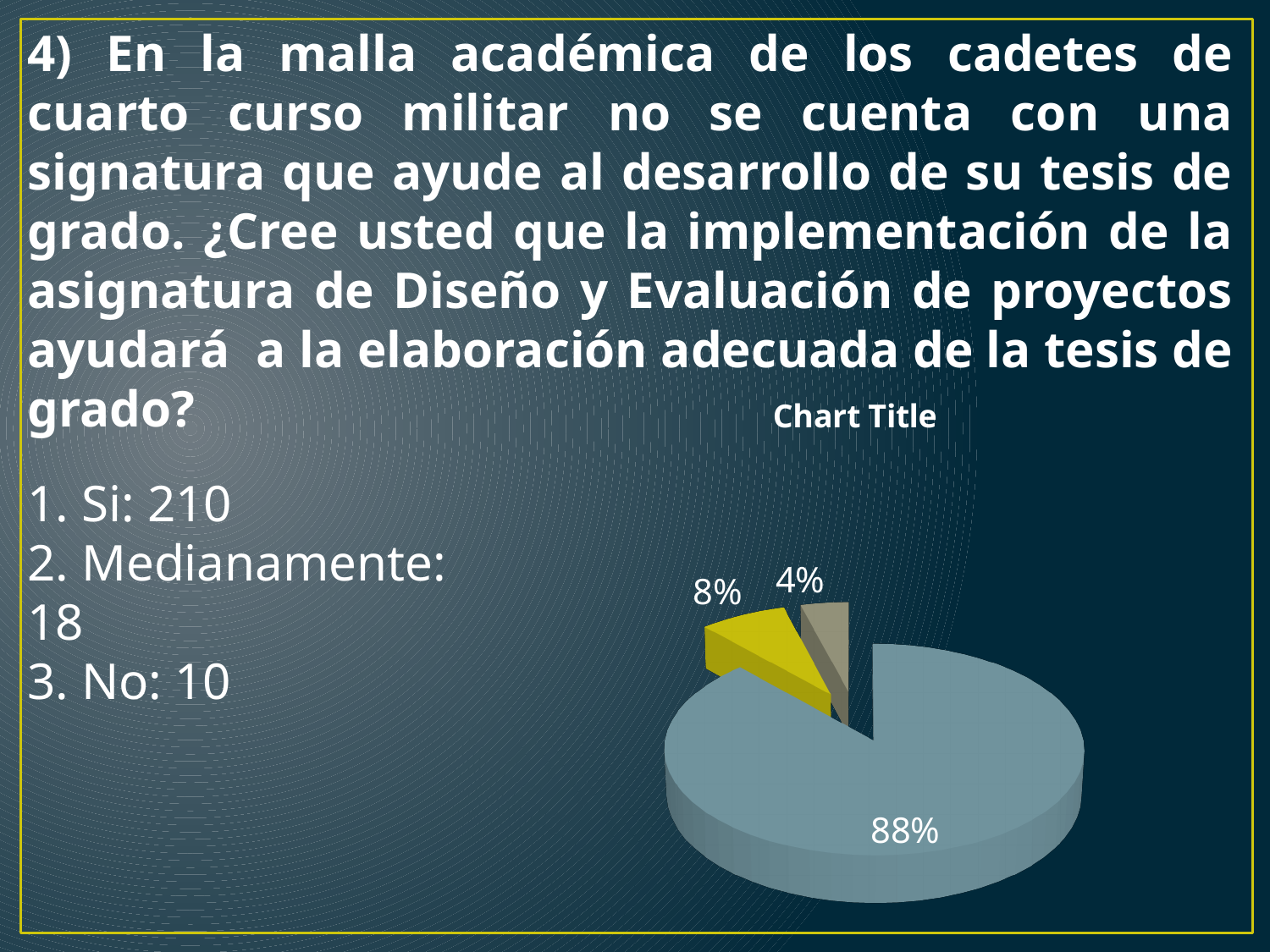
What is the percentage shown on the largest slice of the pie chart? 88% What percentage is labelled on the tan (beige) slice of the pie chart? 4% What is the percentage shown on the smallest slice of the pie chart? 4% What kind of chart is shown on the slide? pie chart What is the title shown above the pie chart? Chart Title What share of the pie does the blue-grey slice represent? 88% What do the three percentage labels on the pie chart add up to? 100% How many slices does the pie chart have? 3 What is the difference in percentage points between the largest slice (88%) and the yellow slice (8%)? 80 percentage points What percentage is labelled on the yellow slice of the pie chart? 8% What is the difference in percentage points between the yellow slice (8%) and the tan slice (4%)? 4 percentage points Which slice is larger, the yellow slice or the tan slice? the yellow slice